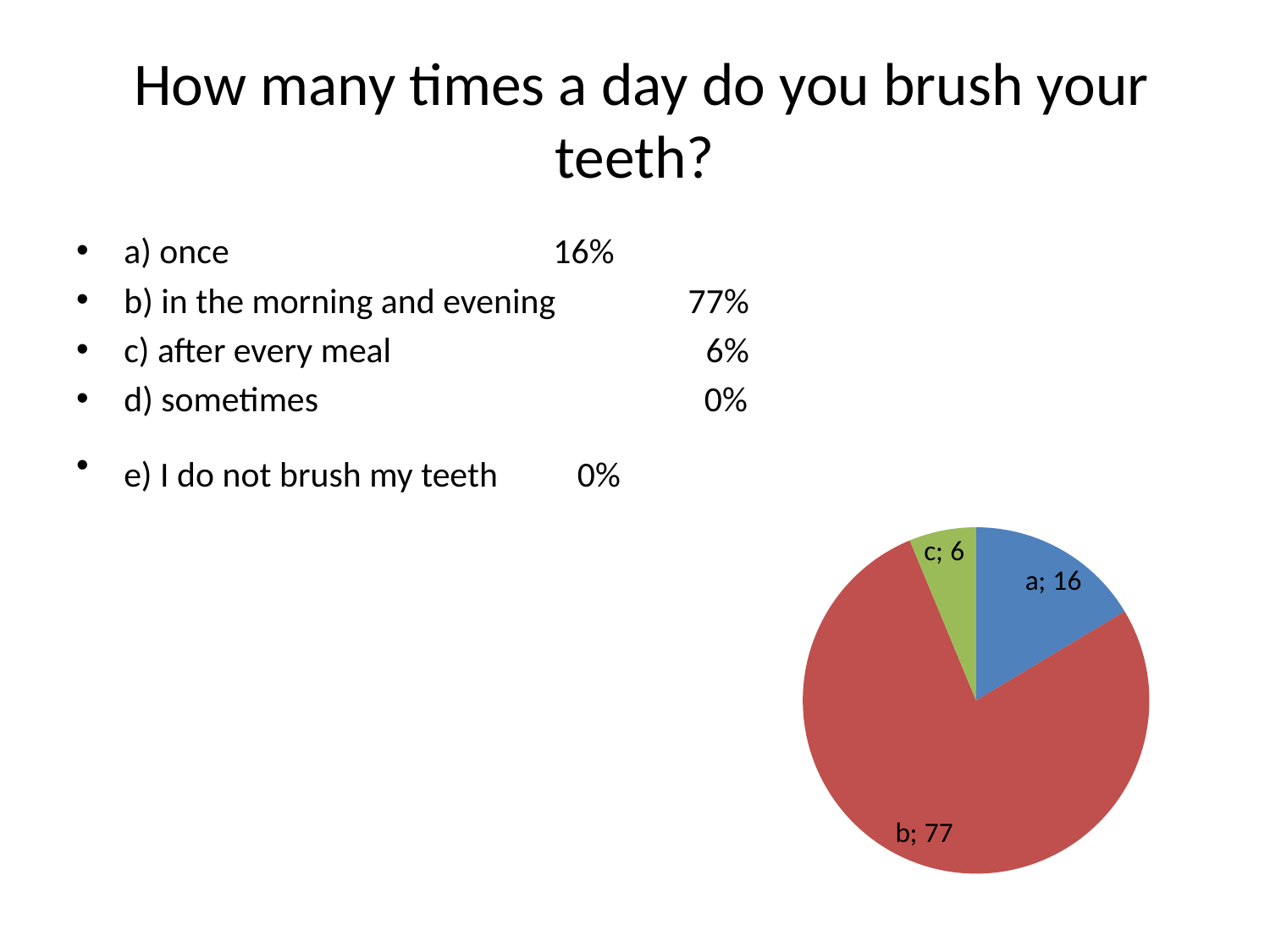
What kind of chart is shown on the slide? pie chart What colour is slice b in the pie chart? red What is the value shown for slice b in the pie chart? 77 Which slice of the pie chart is the smallest? c Which slice of the pie chart is the largest? b What colour is slice c in the pie chart? green Which is larger in the pie chart, slice a or slice c? a What is the difference between the values for slices b and a in the pie chart? 61 What is the value shown for slice c in the pie chart? 6 How many labelled slices does the pie chart have? 3 What is the value shown for slice a in the pie chart? 16 What is the difference between the values for slices a and c in the pie chart? 10